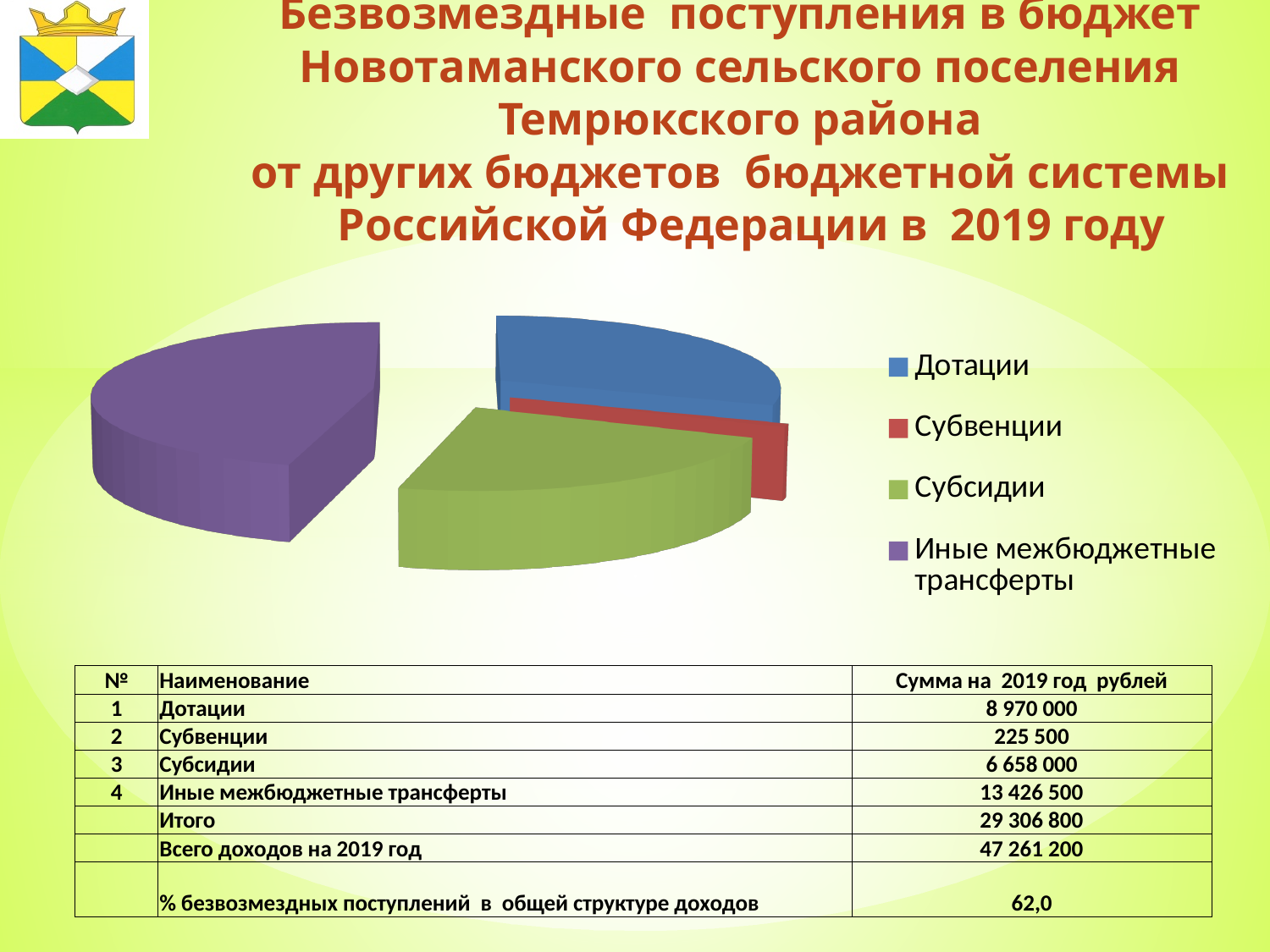
According to the table on the slide, what is the 2019 amount for Дотации? 8 970 000 Which category has the smallest slice of the pie chart? Субвенции According to the table on the slide, what is the 2019 amount for Иные межбюджетные трансферты? 13 426 500 What is the difference between the amounts for Иные межбюджетные трансферты and Дотации? 4 456 500 How many slices does the pie chart have? 4 Which is larger, the amount for Дотации or the amount for Субсидии? Дотации What is the total (Итого) of the four categories shown in the pie chart? 29 306 800 Which category has the largest slice of the pie chart? Иные межбюджетные трансферты What colour represents Субсидии in the pie chart? green According to the table on the slide, what is the 2019 amount for Субвенции? 225 500 How many entries does the chart legend list? 4 What kind of chart is shown on the slide? pie chart